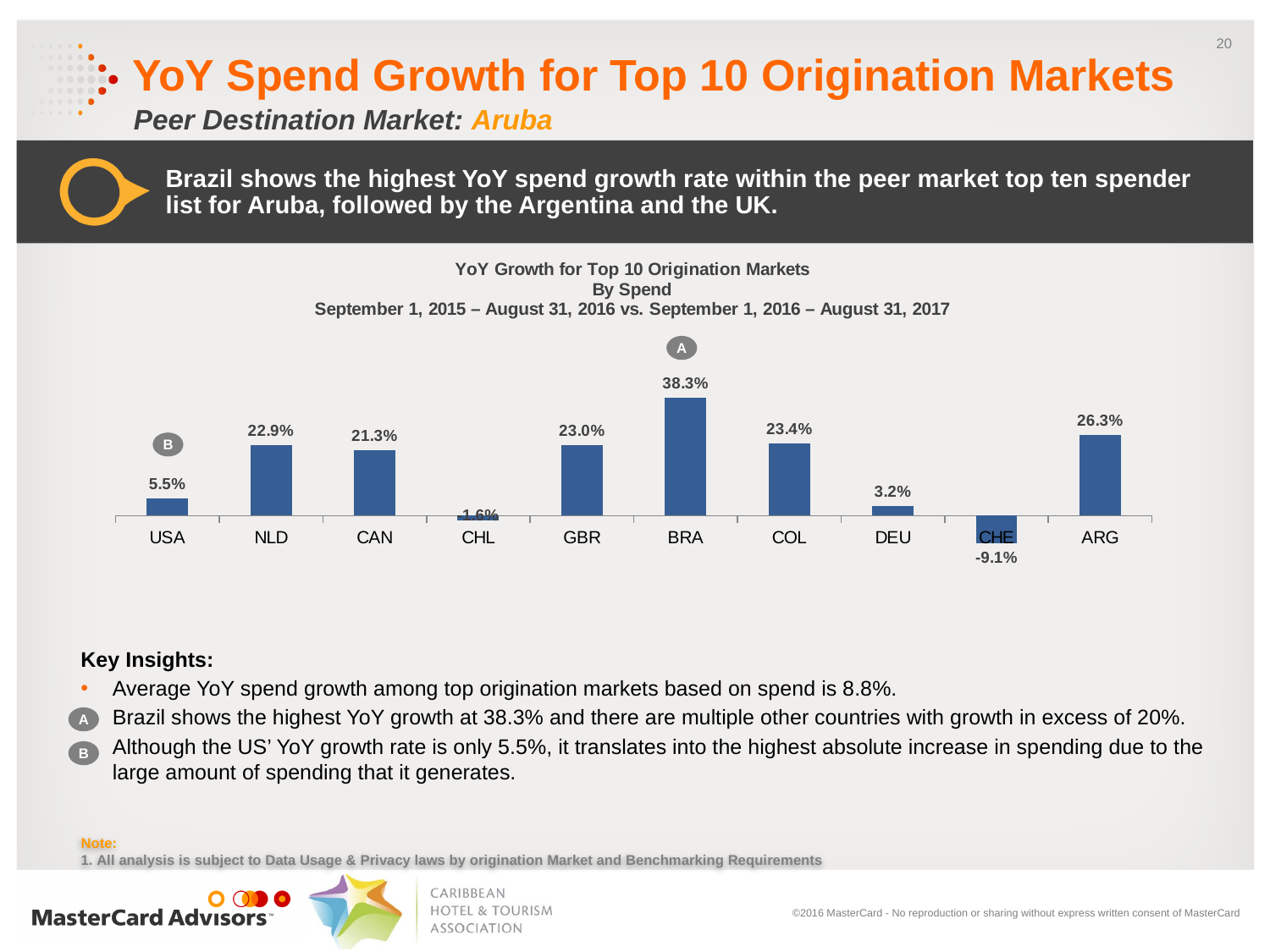
What is the difference between the YoY spend growth of BRA and ARG? 12.0% Which has a higher YoY spend growth, DEU or USA? USA What is the YoY spend growth value for USA? 5.5% What kind of chart is used to show YoY growth for the top 10 origination markets? Bar chart What is the title of the chart? YoY Growth for Top 10 Origination Markets By Spend September 1, 2015 – August 31, 2016 vs. September 1, 2016 – August 31, 2017 What is the YoY spend growth value for BRA? 38.3% Which origination market has the lowest YoY spend growth? CHE What is the difference between the YoY spend growth of NLD and CAN? 1.6% What is the YoY spend growth value for ARG? 26.3% Which origination market has the highest YoY spend growth? BRA What is the YoY spend growth value for CHE? -9.1% How many origination markets are shown in the chart? 10